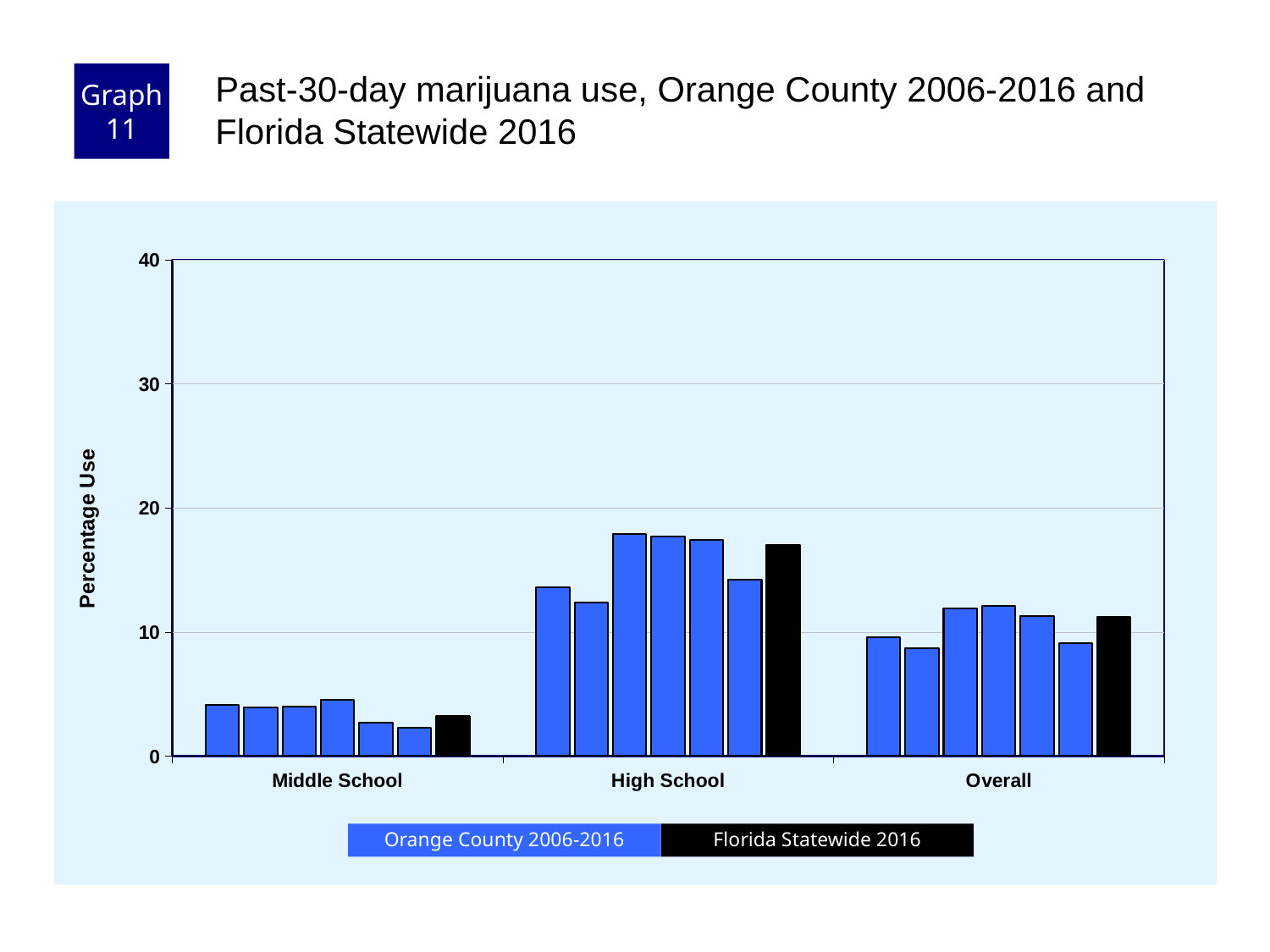
Is the Florida Statewide 2016 value for Middle School greater or less than 10? less Is the Florida Statewide 2016 value for High School greater or less than 10? greater Are all the Orange County 2006-2016 bars for Middle School greater or less than 10? less What is the label on the y axis of the chart? Percentage Use Which category has the lowest bars in the chart? Middle School What colour are the Florida Statewide 2016 bars in the chart? black Which is larger, the Florida Statewide 2016 value for High School or for Overall? High School How many categories are shown on the x axis of the chart? 3 How many series does the chart's legend list? 2 What kind of chart is shown on the slide? bar chart Which category has the highest bars in the chart? High School